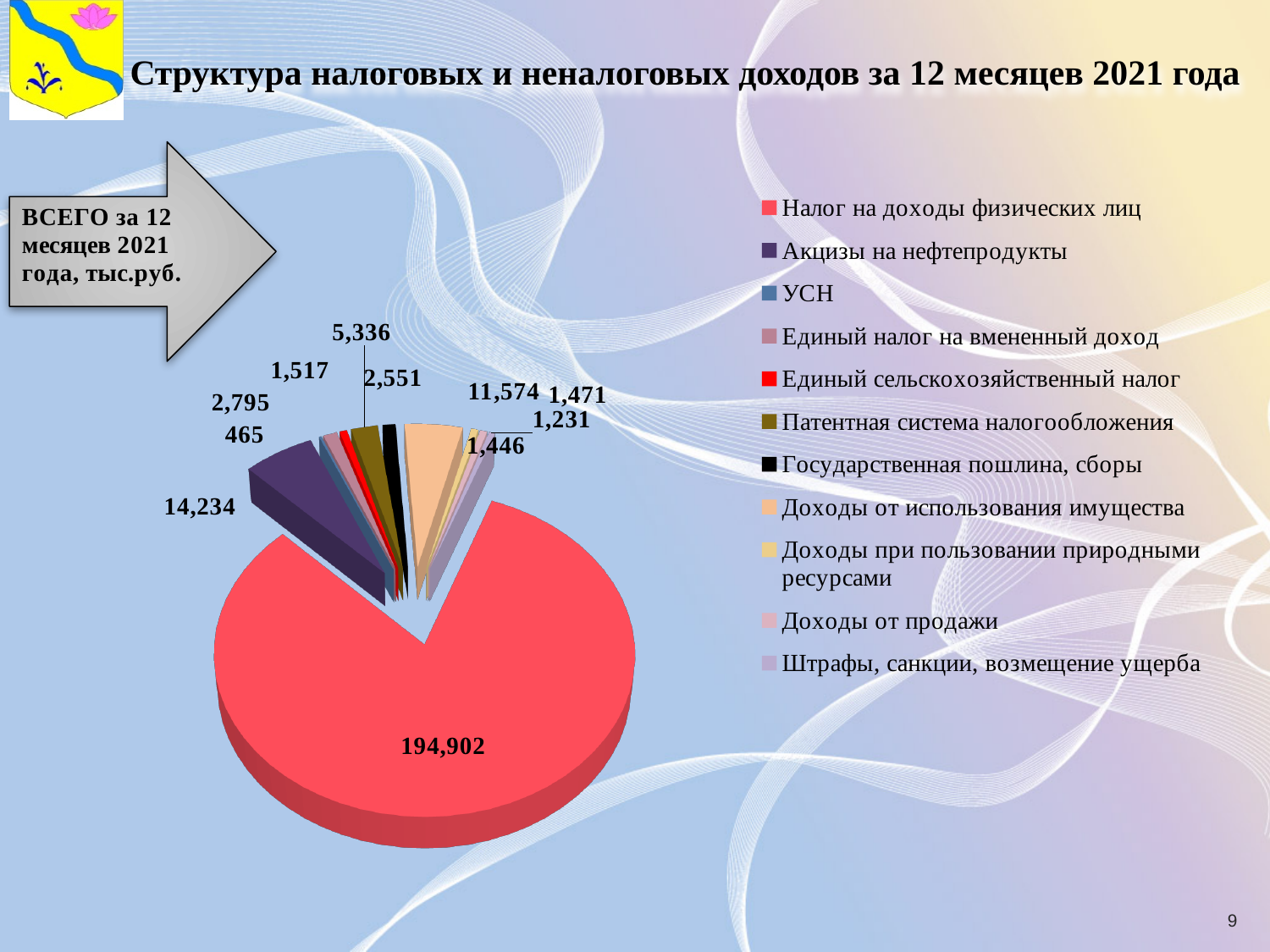
What is the difference between the values for Налог на доходы физических лиц and Акцизы на нефтепродукты? 180,668 What is the value shown for Акцизы на нефтепродукты? 14,234 What is the smallest data label value shown on the pie chart? 465 What is the value shown for Доходы от использования имущества? 11,574 What is the title of the slide containing the pie chart? Структура налоговых и неналоговых доходов за 12 месяцев 2021 года Which is larger: Акцизы на нефтепродукты or Доходы от использования имущества? Акцизы на нефтепродукты What kind of chart is shown on the slide? Pie chart What is the total of all the values labelled on the pie chart? 237,522 Which category has the largest slice in the pie chart? Налог на доходы физических лиц What is the value shown for Налог на доходы физических лиц? 194,902 What is the difference between the values for Акцизы на нефтепродукты and Доходы от использования имущества? 2,660 How many categories does the legend of the pie chart list? 11